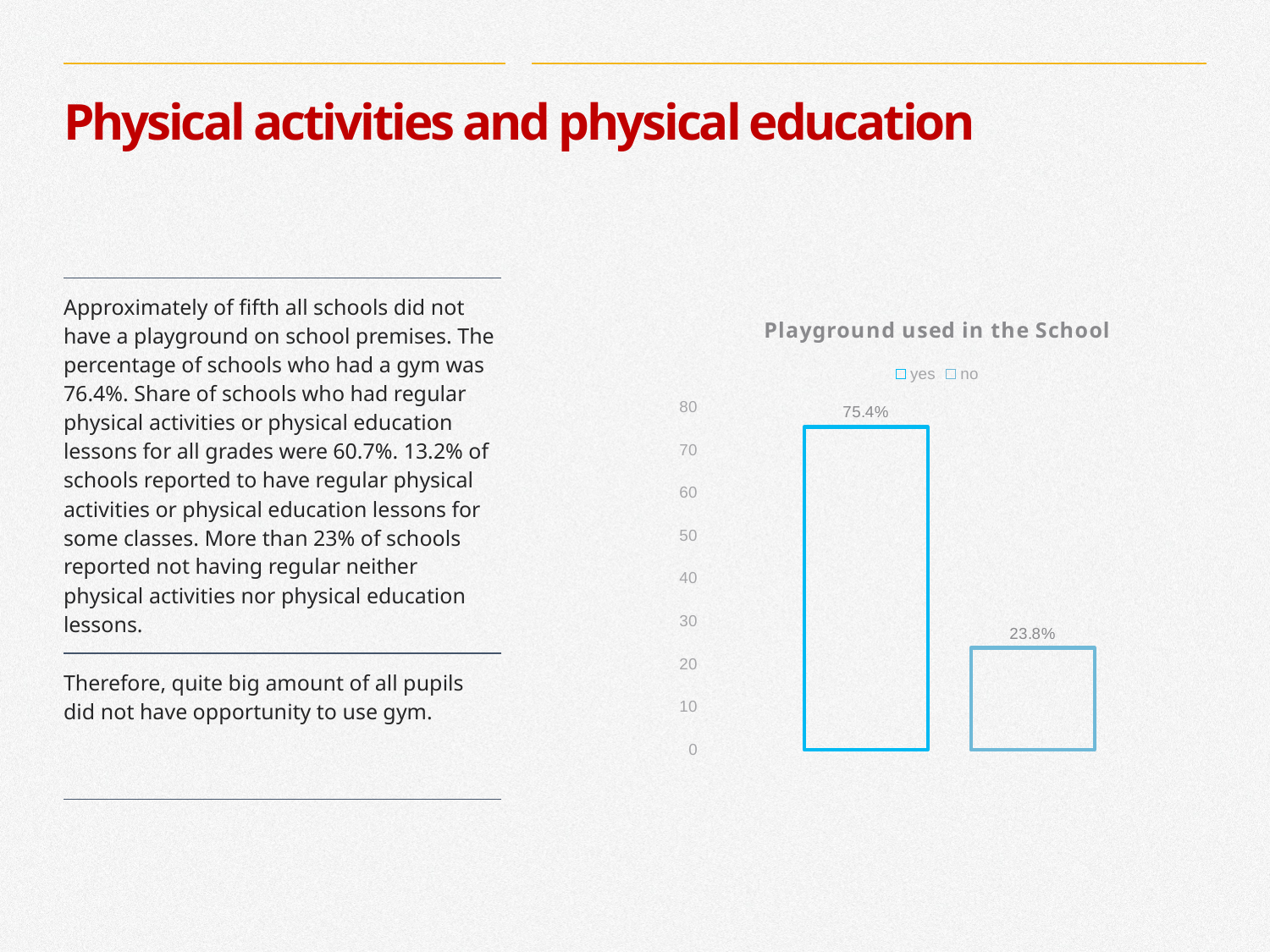
Is the value for "yes" greater or less than 70? greater Which is larger in the chart, the value for "yes" or the value for "no"? yes What is the title of the chart on the slide? Playground used in the School Is the value for "no" greater or less than 30? less Which category has the highest value in the chart? yes What is the difference between the "yes" and "no" values in the chart? 51.6% How many entries does the chart legend list? 2 What is the value for "no" in the Playground used in the School chart? 23.8% Which category has the lowest value in the chart? no What kind of chart is shown on the slide? bar chart How many bars are plotted in the chart? 2 What is the value for "yes" in the Playground used in the School chart? 75.4%